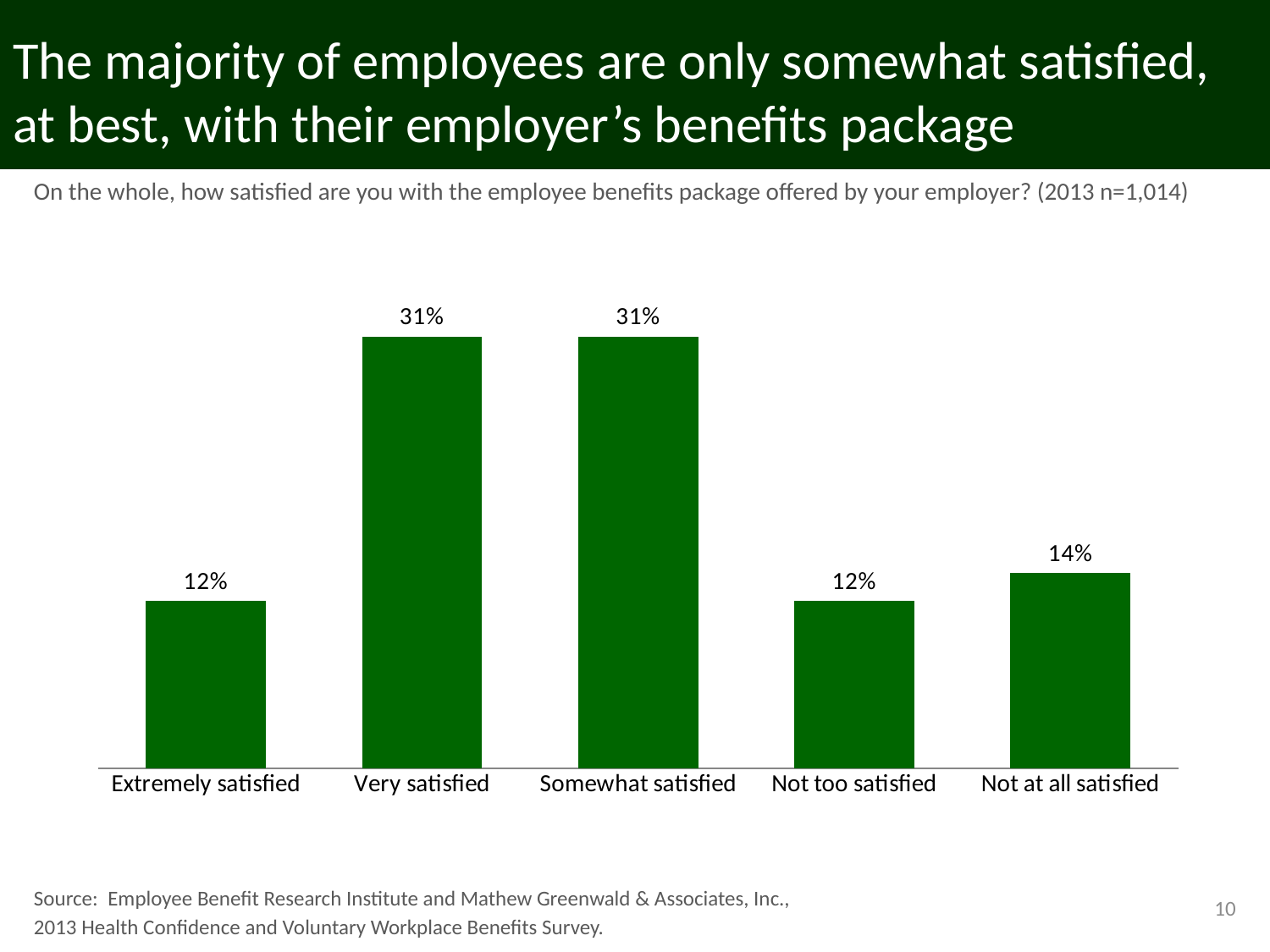
Which is larger: the value for Not at all satisfied or the value for Extremely satisfied? Not at all satisfied What percentage of employees are not at all satisfied with their employer's benefits package? 14% What is the difference between the percentage for Not at all satisfied and the percentage for Not too satisfied? 2% Which categories share the highest value in the chart? Very satisfied and Somewhat satisfied What percentage of employees are extremely satisfied with their employer's benefits package? 12% What percentage of employees are not too satisfied with their employer's benefits package? 12% How many response categories are shown in the chart? 5 What kind of chart is shown on the slide? Bar chart What is the difference between the percentage for Very satisfied and the percentage for Not at all satisfied? 17% What is the sample size (n) given for the 2013 survey question shown above the chart? 1,014 What percentage of employees are very satisfied with their employer's benefits package? 31% Which is larger: the value for Somewhat satisfied or the value for Not too satisfied? Somewhat satisfied